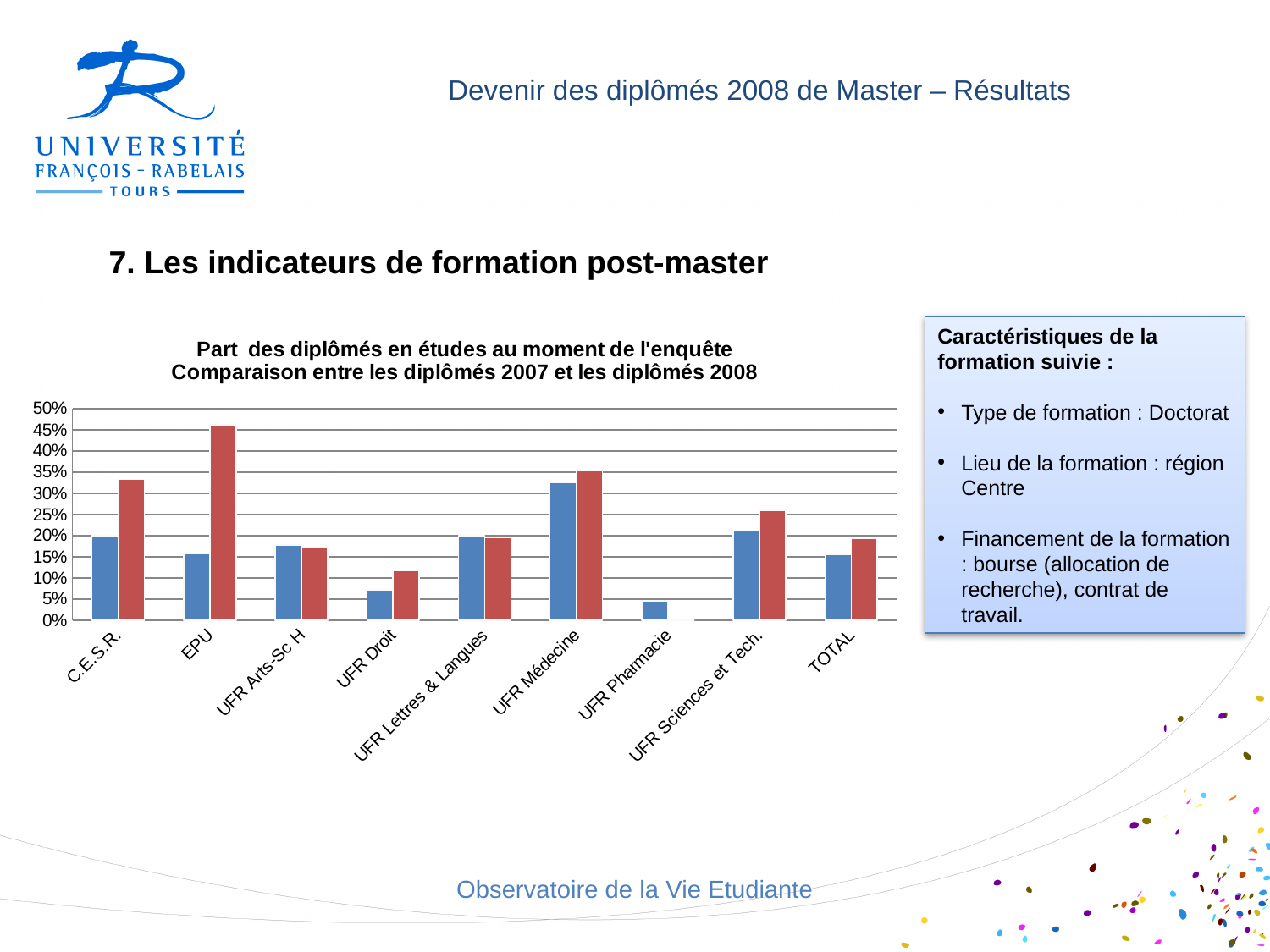
What is the first line of the chart's title? Part des diplômés en études au moment de l'enquête Which category has the shortest blue bar? UFR Pharmacie Is the red bar for C.E.S.R. greater or less than 30%? greater For C.E.S.R., which bar is taller, the blue one or the red one? the red one Is the blue bar for UFR Droit greater or less than 10%? less Which category has the tallest red bar? EPU Which is taller: the red bar for EPU or the red bar for UFR Médecine? EPU Is the red bar for EPU greater or less than 40%? greater Which category has the tallest blue bar? UFR Médecine How many categories are shown on the x axis of the chart? 9 What kind of chart is shown on the slide? bar chart